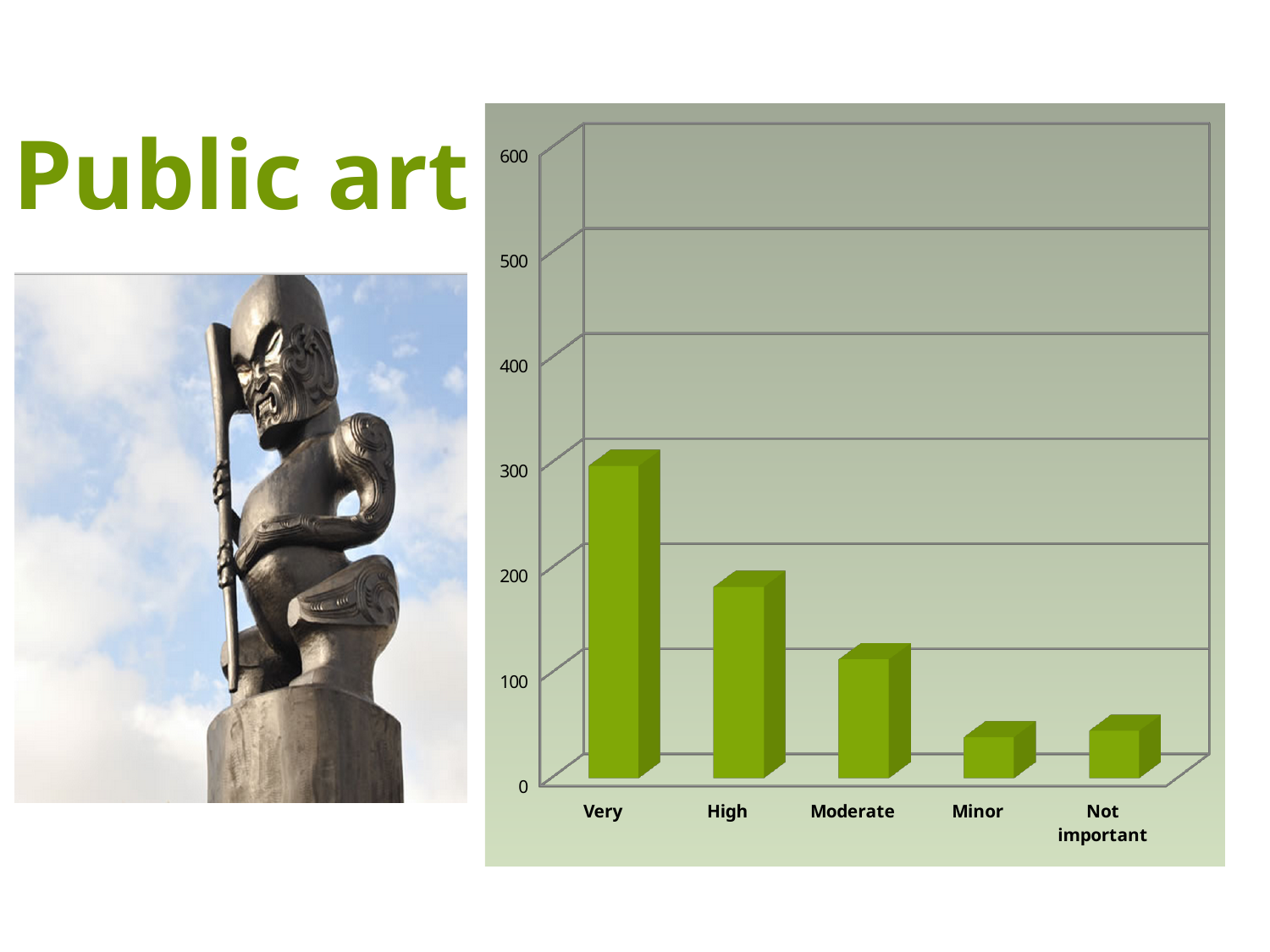
Is the value for High greater or less than 100? greater Is the value for Minor greater or less than 100? less Is the value for High greater or less than 300? less How many categories are shown on the x axis of the chart? 5 Which is larger, the value for Very or the value for High? Very What kind of chart is shown on the slide? bar chart Do the values rise or fall from Very to Minor along the x axis? fall Which category has the highest value in the chart? Very What colour are the bars in the chart? green Which is larger, the value for High or the value for Moderate? High